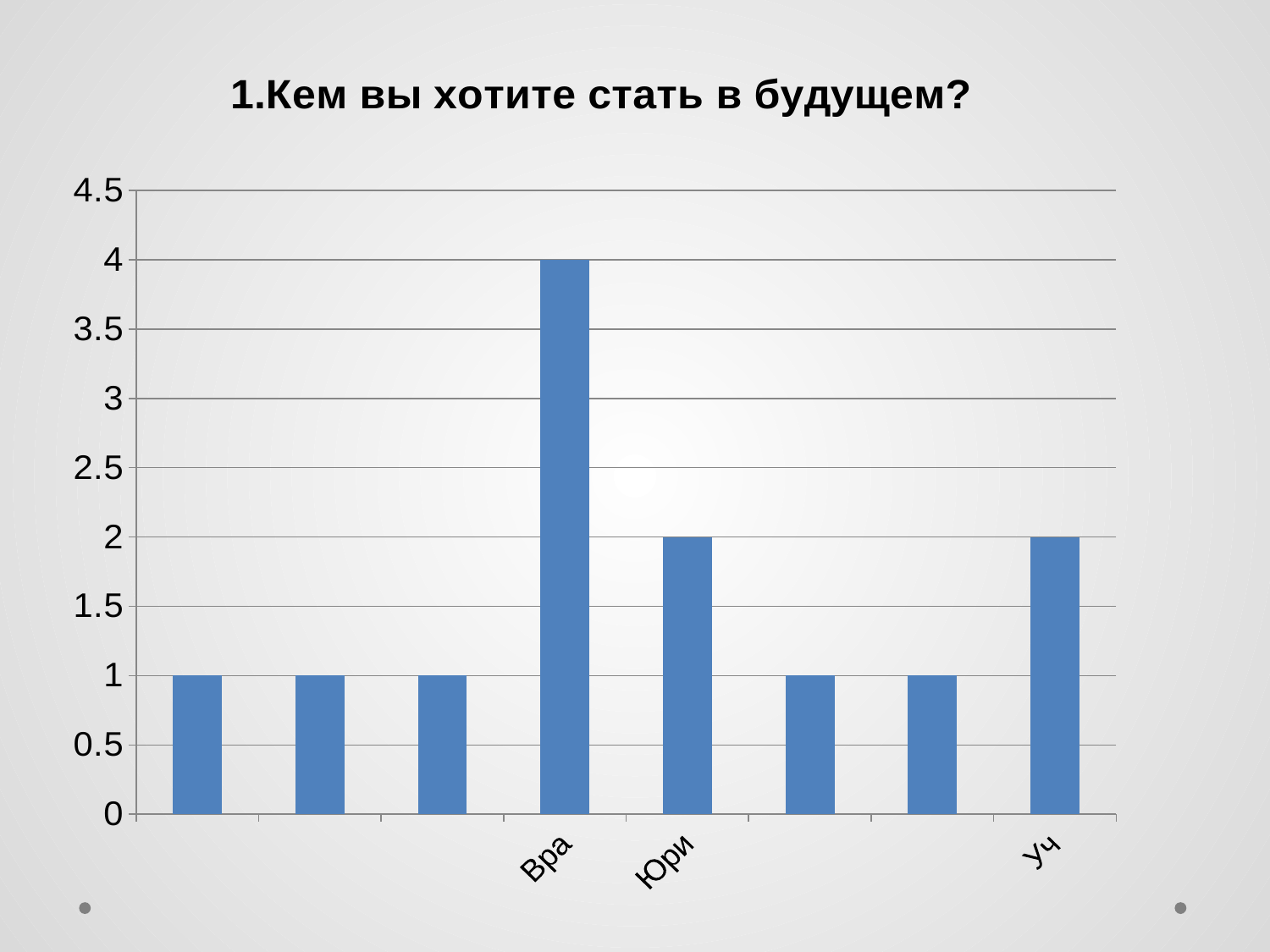
What is the value for Юри? 2 What is the title of the chart? 1.Кем вы хотите стать в будущем? What is the value for Уч? 2 What is the value for Вра? 4 Is the value for Вра greater or less than 3? greater What colour are the bars in the chart? blue What is the difference between the values for Вра and Юри? 2 What kind of chart is shown on the slide? bar chart How many bars are plotted in the chart? 8 Which category has the highest bar? Вра Which is larger, the value for Вра or the value for Юри? Вра Is the value for Уч greater or less than 3? less